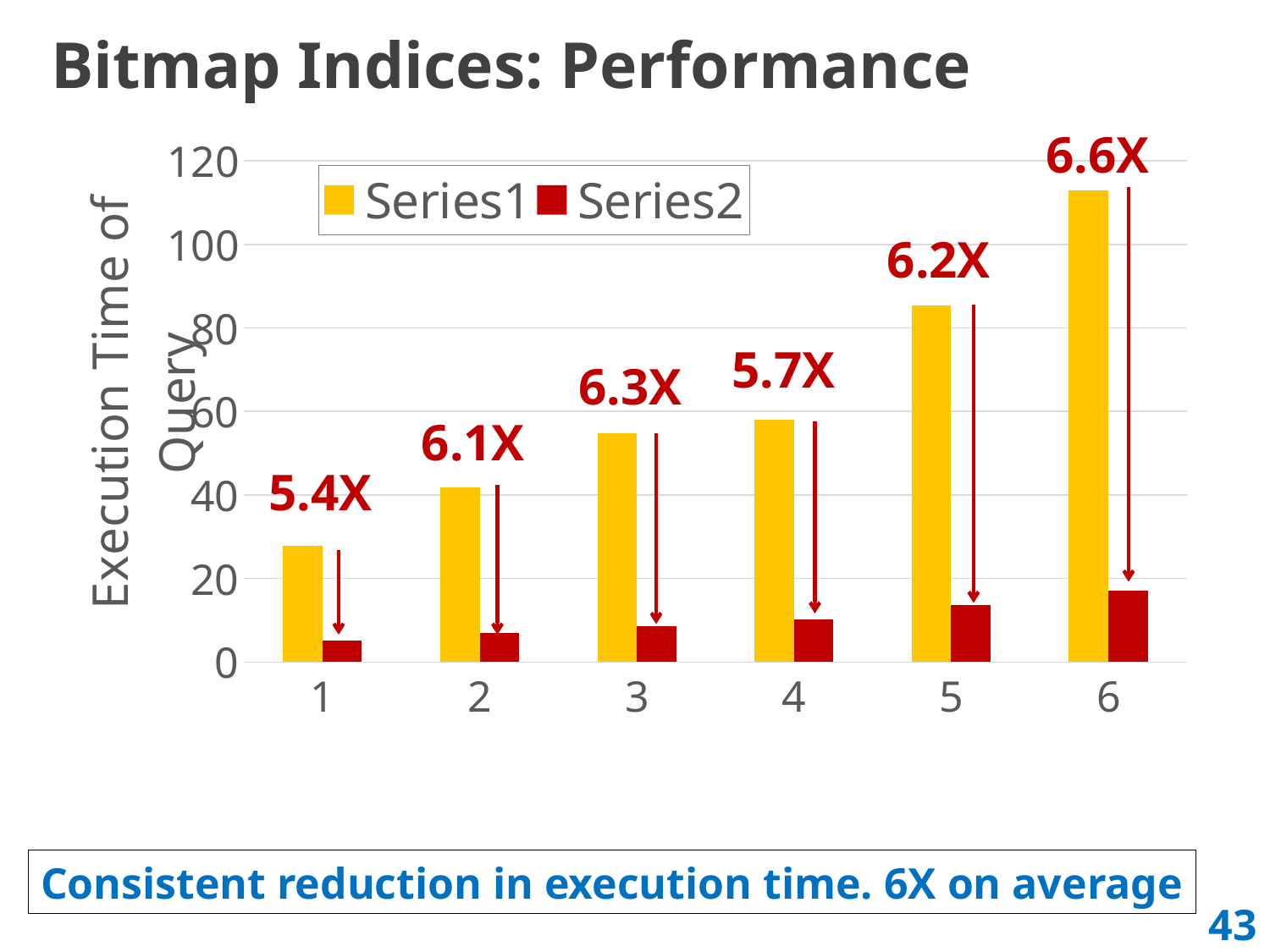
Do the Series1 values rise or fall from category 1 to category 6? rise Is the Series2 value for category 6 greater or less than 20? less Which category has the highest Series1 value? 6 For category 3, which is larger, Series1 or Series2? Series1 How many series does the legend list? 2 What kind of chart is shown on the slide? bar chart Which category has the lowest Series1 value? 1 How many categories are shown on the x axis? 6 Is the Series1 value for category 1 greater or less than 40? less Which category has the lowest Series2 value? 1 Is the Series1 value for category 6 greater or less than 100? greater What speedup label is printed above the bars for category 6? 6.6X